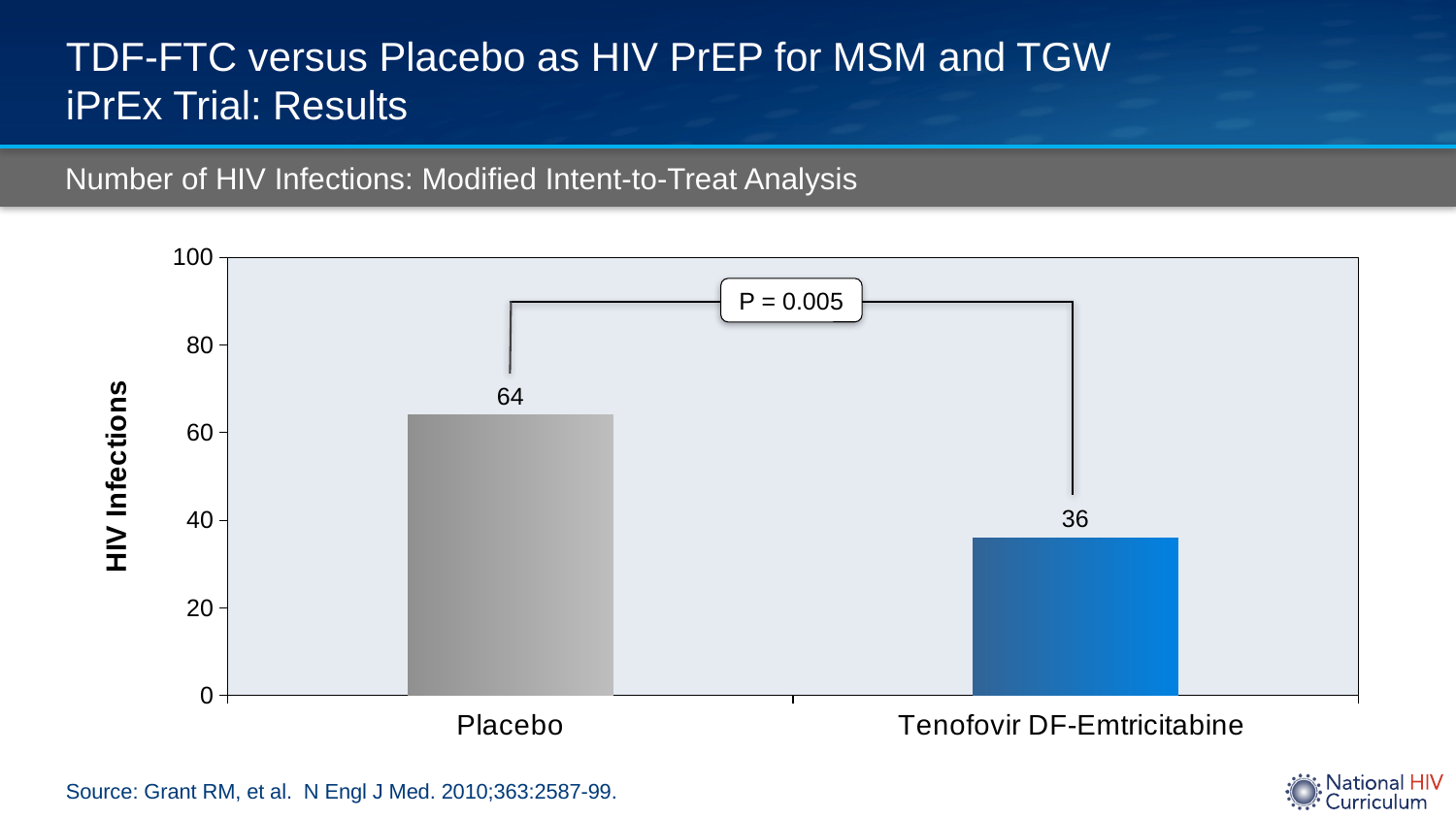
How many groups are plotted on the chart? 2 Is the value for Placebo greater or less than 60? greater What kind of chart is shown on the slide? Bar chart Is the number of HIV infections greater for Placebo or for Tenofovir DF-Emtricitabine? Placebo What is the P value shown on the chart? P = 0.005 How many HIV infections are shown for the Placebo group? 64 What is the difference in HIV infections between the Placebo and Tenofovir DF-Emtricitabine groups? 28 How many HIV infections are shown for the Tenofovir DF-Emtricitabine group? 36 Which group has the lower number of HIV infections? Tenofovir DF-Emtricitabine Which group has the higher number of HIV infections? Placebo What is the label of the y axis? HIV Infections Is the value for Tenofovir DF-Emtricitabine greater or less than 40? less